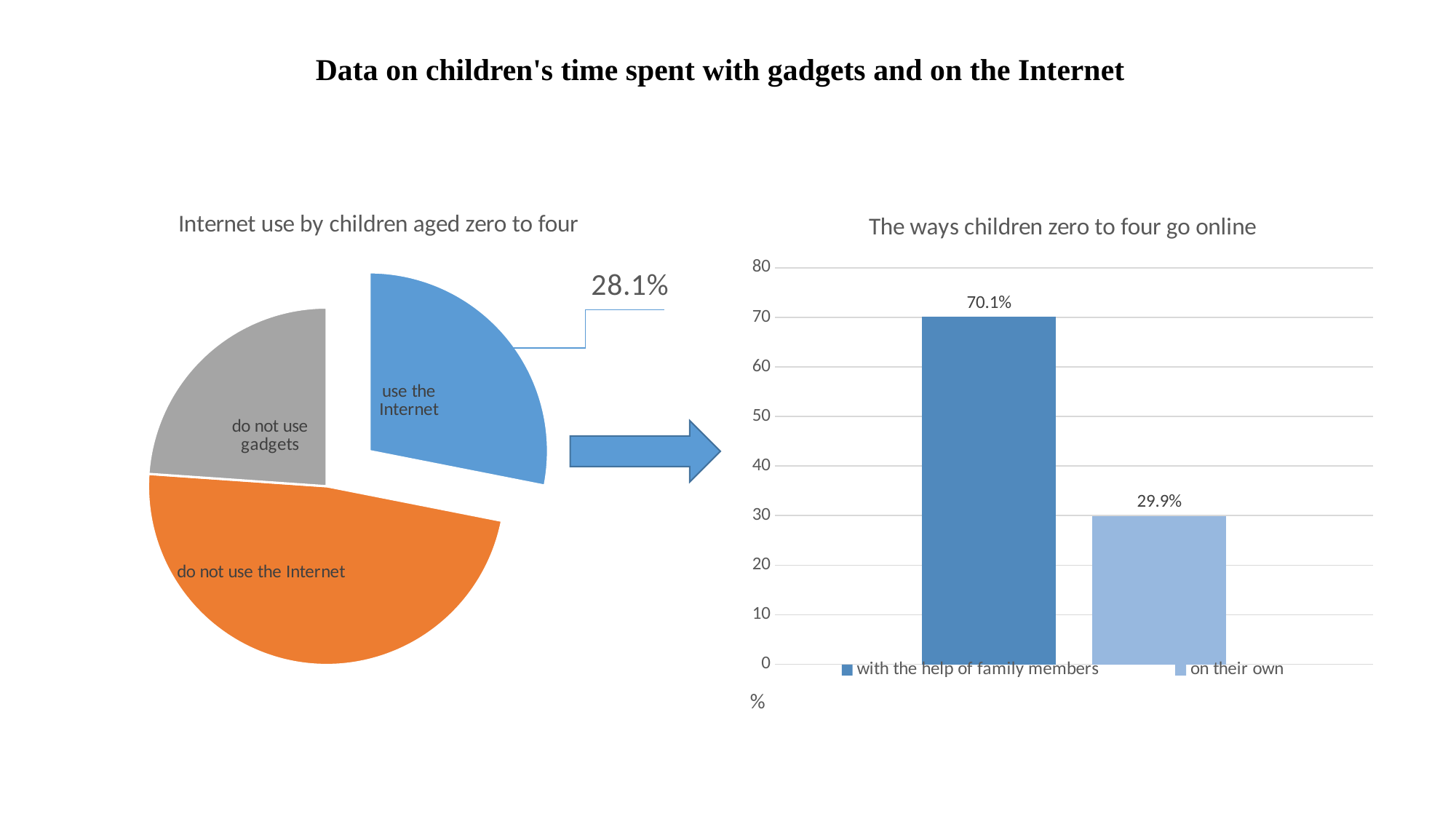
In the pie chart 'Internet use by children aged zero to four', which slice is larger: 'do not use the Internet' or 'use the Internet'? do not use the Internet In the chart 'The ways children zero to four go online', what is the difference between 'with the help of family members' and 'on their own'? 40.2% In the chart 'The ways children zero to four go online', is the value for 'on their own' greater or less than 40? less What kind of chart is 'Internet use by children aged zero to four'? pie chart How many entries does the legend of the chart 'The ways children zero to four go online' list? 2 In the chart 'The ways children zero to four go online', what is the value for 'on their own'? 29.9% In the pie chart 'Internet use by children aged zero to four', which slice is the largest? do not use the Internet In the chart 'The ways children zero to four go online', what is the value for 'with the help of family members'? 70.1% In the chart 'The ways children zero to four go online', which is larger: 'with the help of family members' or 'on their own'? with the help of family members What kind of chart is 'The ways children zero to four go online'? bar chart How many slices does the pie chart 'Internet use by children aged zero to four' have? 3 In the pie chart 'Internet use by children aged zero to four', what percentage of children use the Internet? 28.1%